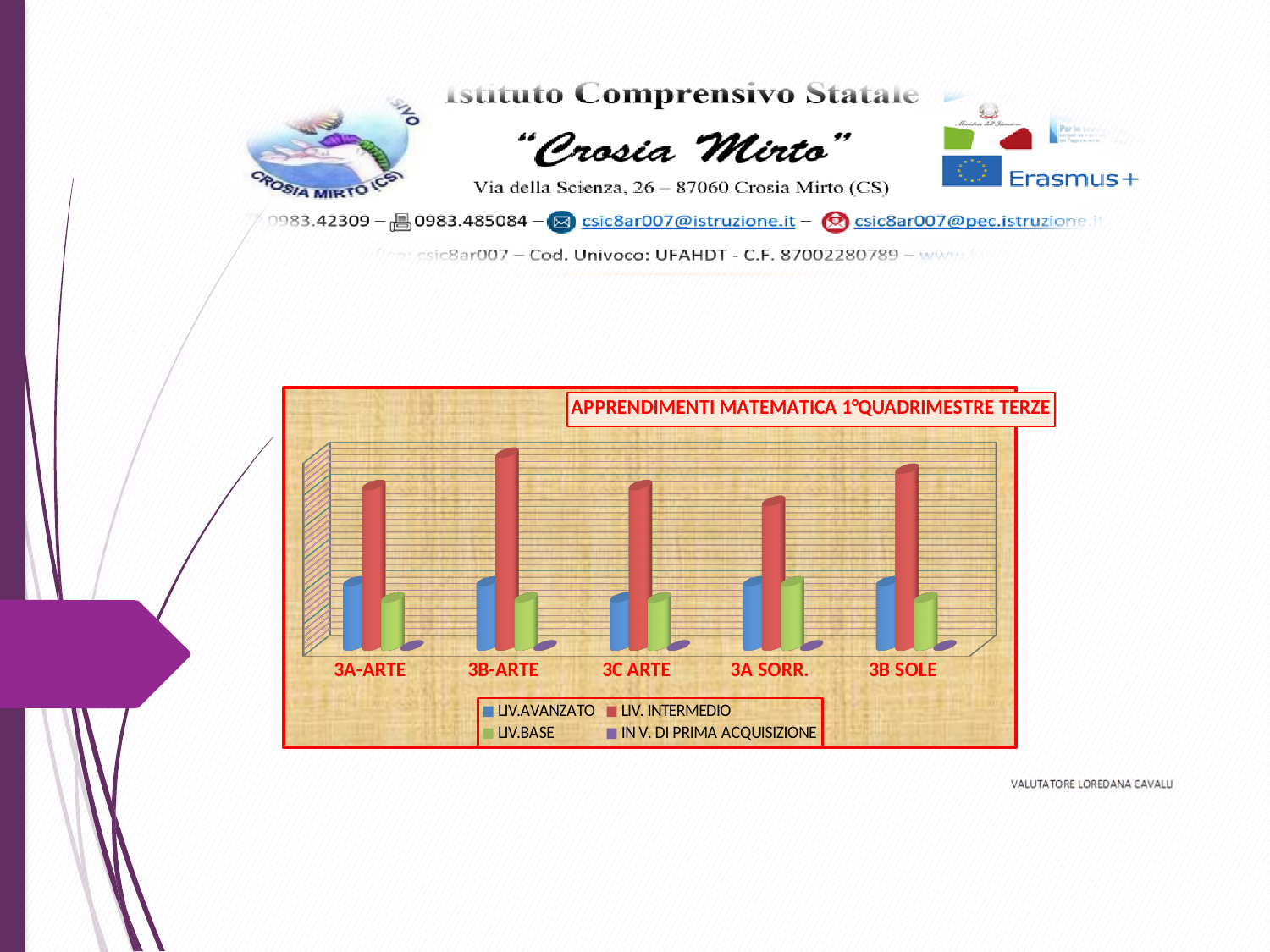
Which series has the tallest bar in every class? LIV. INTERMEDIO What is the title of the chart? APPRENDIMENTI MATEMATICA 1°QUADRIMESTRE TERZE Which class has the shortest LIV.AVANZATO bar? 3C ARTE Is the LIV. INTERMEDIO bar larger for 3B-ARTE or for 3B SOLE? 3B-ARTE Which class has the tallest LIV.BASE bar? 3A SORR. How many classes (categories) are shown on the x axis of the chart? 5 What type of chart is shown on the slide? bar chart Which class has the tallest LIV. INTERMEDIO bar? 3B-ARTE How many series does the chart legend list? 4 Which class has the shortest LIV. INTERMEDIO bar? 3A SORR. Which colour represents LIV. INTERMEDIO in the legend? red Is the LIV.AVANZATO bar larger for 3A SORR. or for 3C ARTE? 3A SORR.